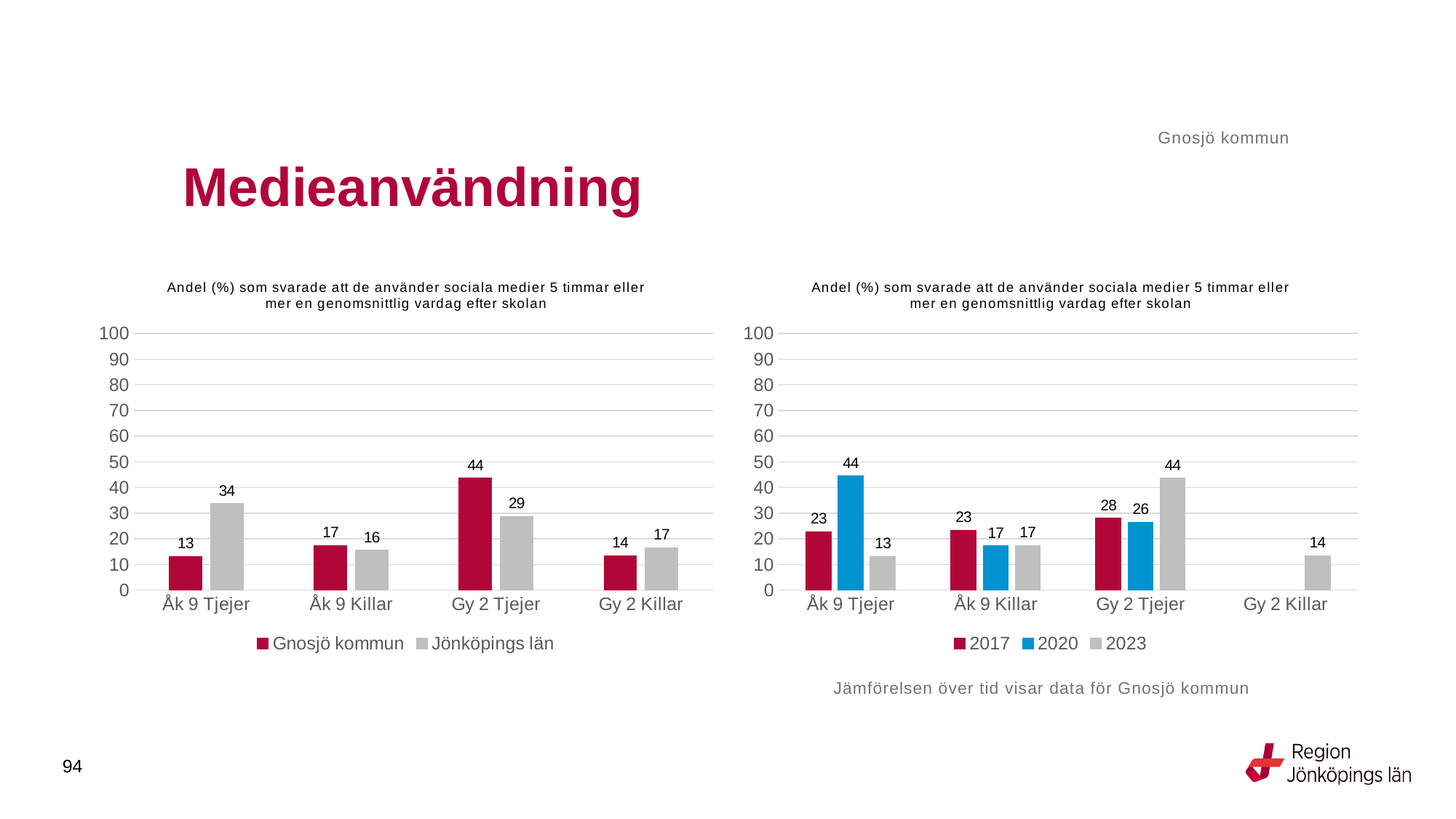
In the right chart, which category has the lowest value for 2023? Åk 9 Tjejer In the right chart, what is the value for 2023 for Gy 2 Killar? 14 In the left chart, what is the difference between Jönköpings län and Gnosjö kommun for Åk 9 Tjejer? 21 How many series does the legend of the right chart list? 3 How many series does the legend of the left chart list? 2 In the left chart, what is the value for Jönköpings län for Åk 9 Tjejer? 34 In the left chart, what is the value for Gnosjö kommun for Gy 2 Tjejer? 44 In the left chart, which category has the highest value for Gnosjö kommun? Gy 2 Tjejer In the left chart, which is larger for Gy 2 Killar: Gnosjö kommun or Jönköpings län? Jönköpings län In the right chart, what is the difference between the 2023 and 2017 values for Gy 2 Tjejer? 16 What type of chart is the right chart? Bar chart In the right chart, what is the value for 2020 for Åk 9 Tjejer? 44